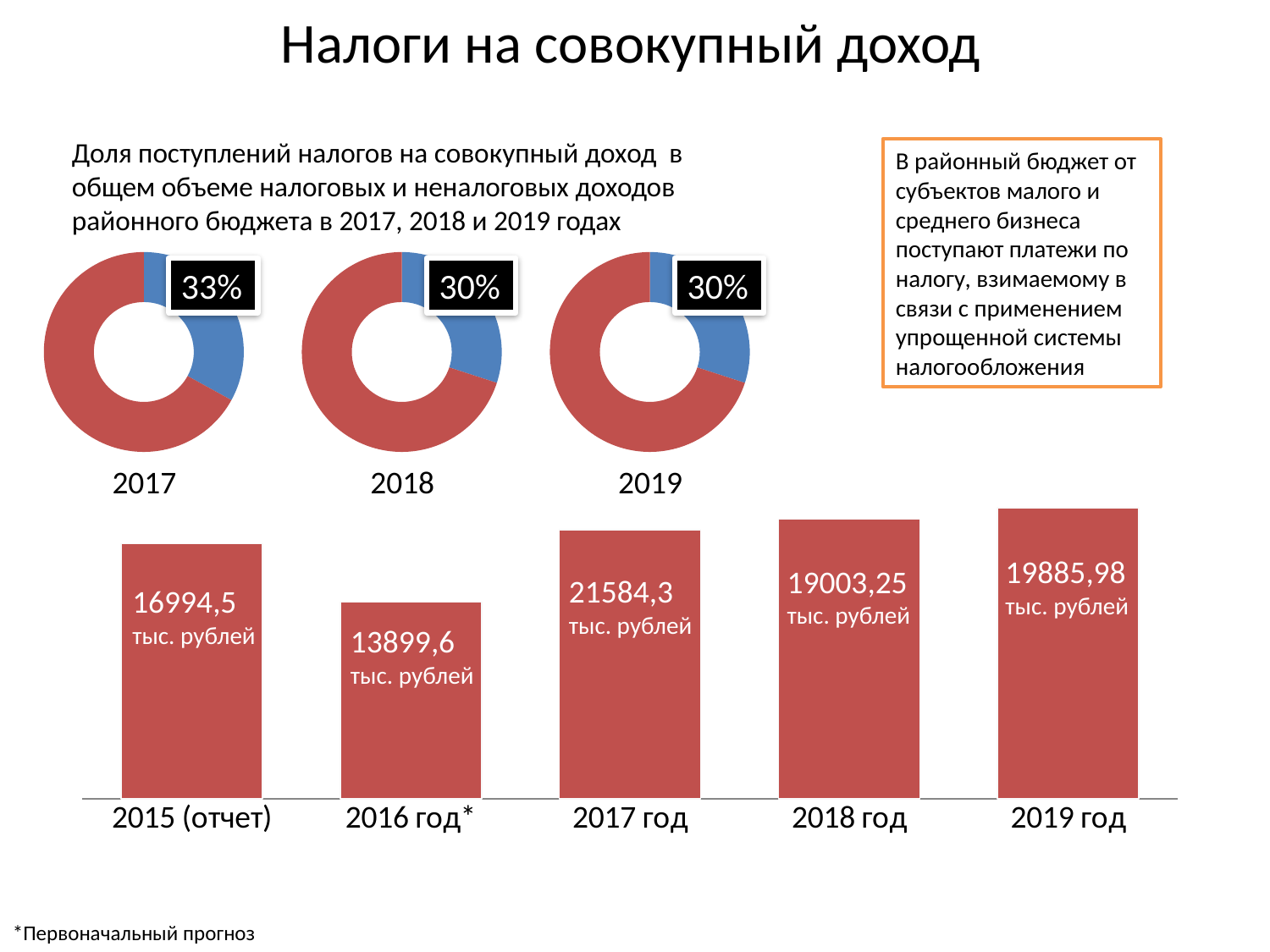
How many bars are in the bar chart at the bottom of the slide? 5 What kind of chart is shown at the bottom of the slide? bar chart In the bar chart at the bottom of the slide, what is the value for 2015 (отчет)? 16994,5 тыс. рублей How many donut charts are shown in the upper part of the slide? 3 In the bar chart at the bottom of the slide, what is the difference between the values for 2017 год and 2016 год*? 7684,7 тыс. рублей In the bar chart at the bottom of the slide, what is the value for 2017 год? 21584,3 тыс. рублей In the donut chart labelled 2017, what share is shown by the data label? 33% In the bar chart at the bottom of the slide, which is larger: the value for 2018 год or the value for 2019 год? 2019 год In the bar chart at the bottom of the slide, which category has the lowest value? 2016 год* In the donut chart labelled 2019, what share is shown by the data label? 30% In the bar chart at the bottom of the slide, what is the value for 2019 год? 19885,98 тыс. рублей